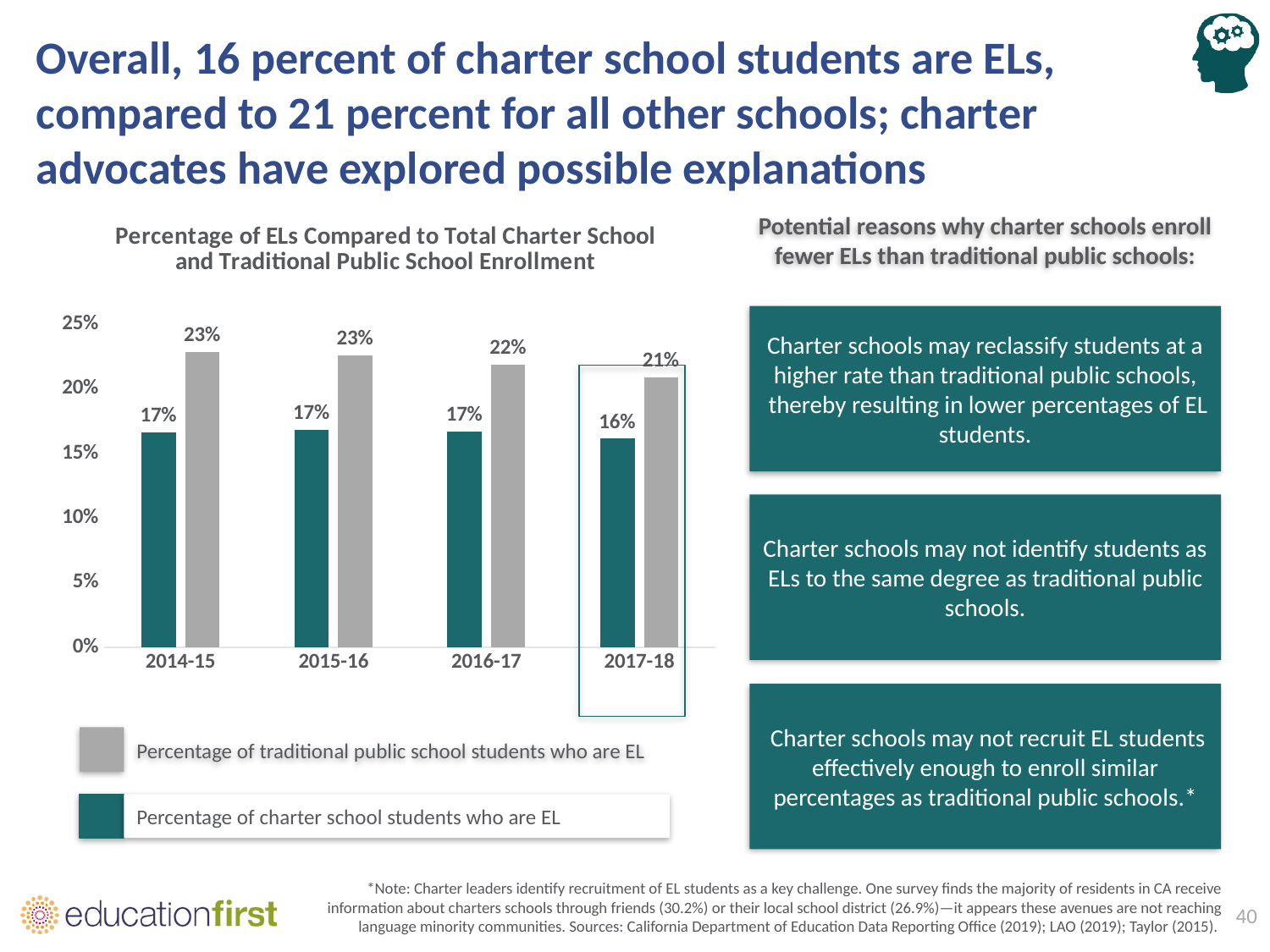
What percentage of traditional public school students were EL in 2014-15? 23% How many series does the chart's legend list? 2 What is the difference between the traditional public school and charter school EL percentages in 2014-15? 6% In which school year was the percentage of traditional public school students who are EL the lowest? 2017-18 How many school years are shown on the x axis of the chart? 4 What is the difference between the percentage of traditional public school students who are EL and the percentage of charter school students who are EL in 2017-18? 5% What percentage of traditional public school students were EL in 2016-17? 22% What percentage of charter school students were EL in 2017-18? 16% What kind of chart is shown on the slide? Bar chart What percentage of charter school students were EL in 2015-16? 17% Does the percentage of traditional public school students who are EL rise or fall from 2014-15 to 2017-18? Fall In 2016-17, which is larger: the percentage of traditional public school students who are EL or the percentage of charter school students who are EL? Percentage of traditional public school students who are EL